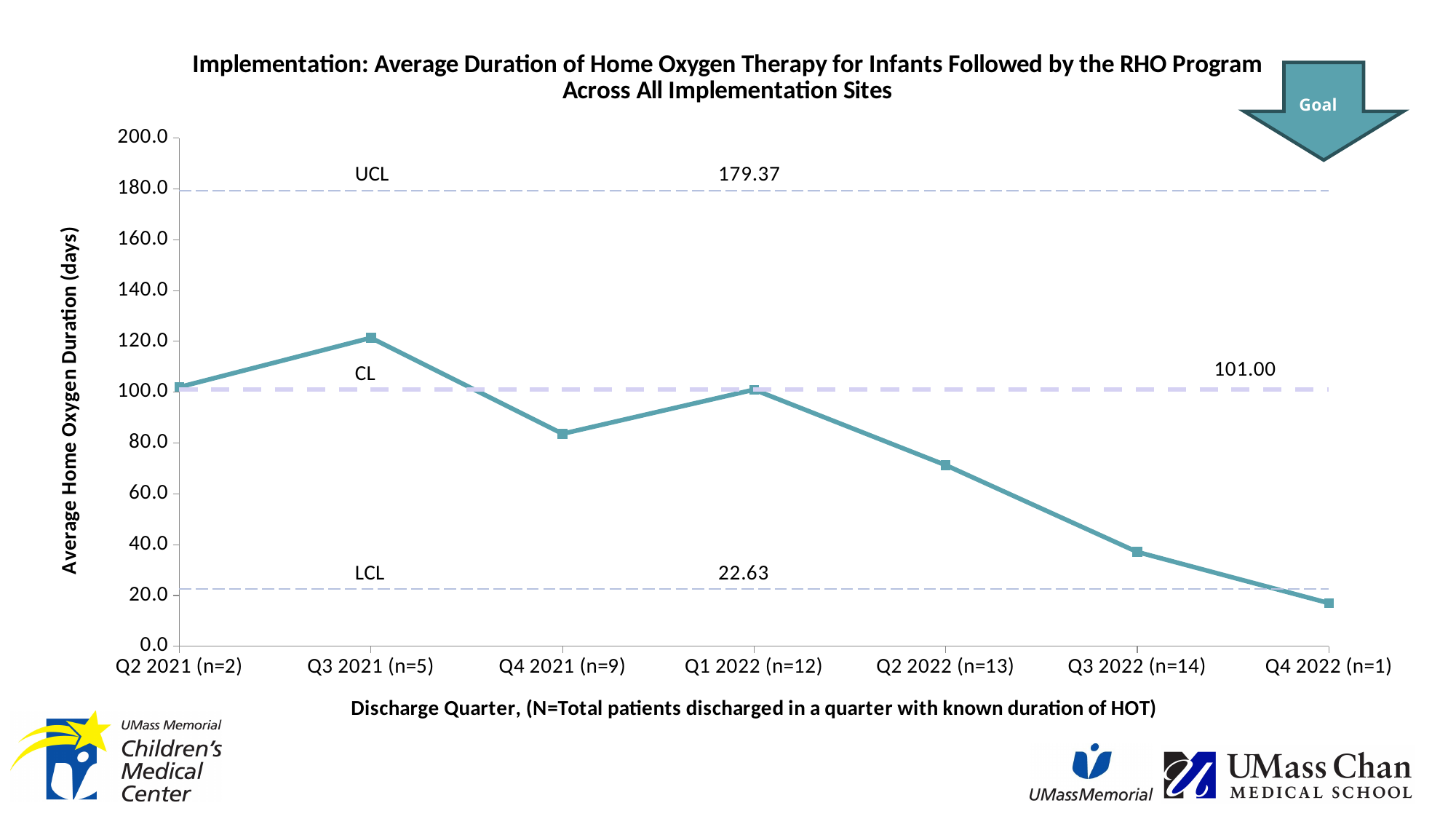
What is the difference between the UCL and the LCL values? 156.74 Which discharge quarter has the lowest average home oxygen duration? Q4 2022 (n=1) What is the value of the UCL (upper control limit) shown on the chart? 179.37 Which is larger, the value for Q4 2021 (n=9) or the value for Q2 2022 (n=13)? Q4 2021 (n=9) What kind of chart is shown on the slide? Line chart How many discharge quarters are plotted along the x axis? 7 Is the value for Q3 2022 (n=14) greater or less than 40? less From Q3 2021 to Q4 2022, do the plotted values generally rise or fall? Fall What is the value of the LCL (lower control limit) shown on the chart? 22.63 Which discharge quarter has the highest average home oxygen duration? Q3 2021 (n=5) What is the value of the CL (center line) shown on the chart? 101.00